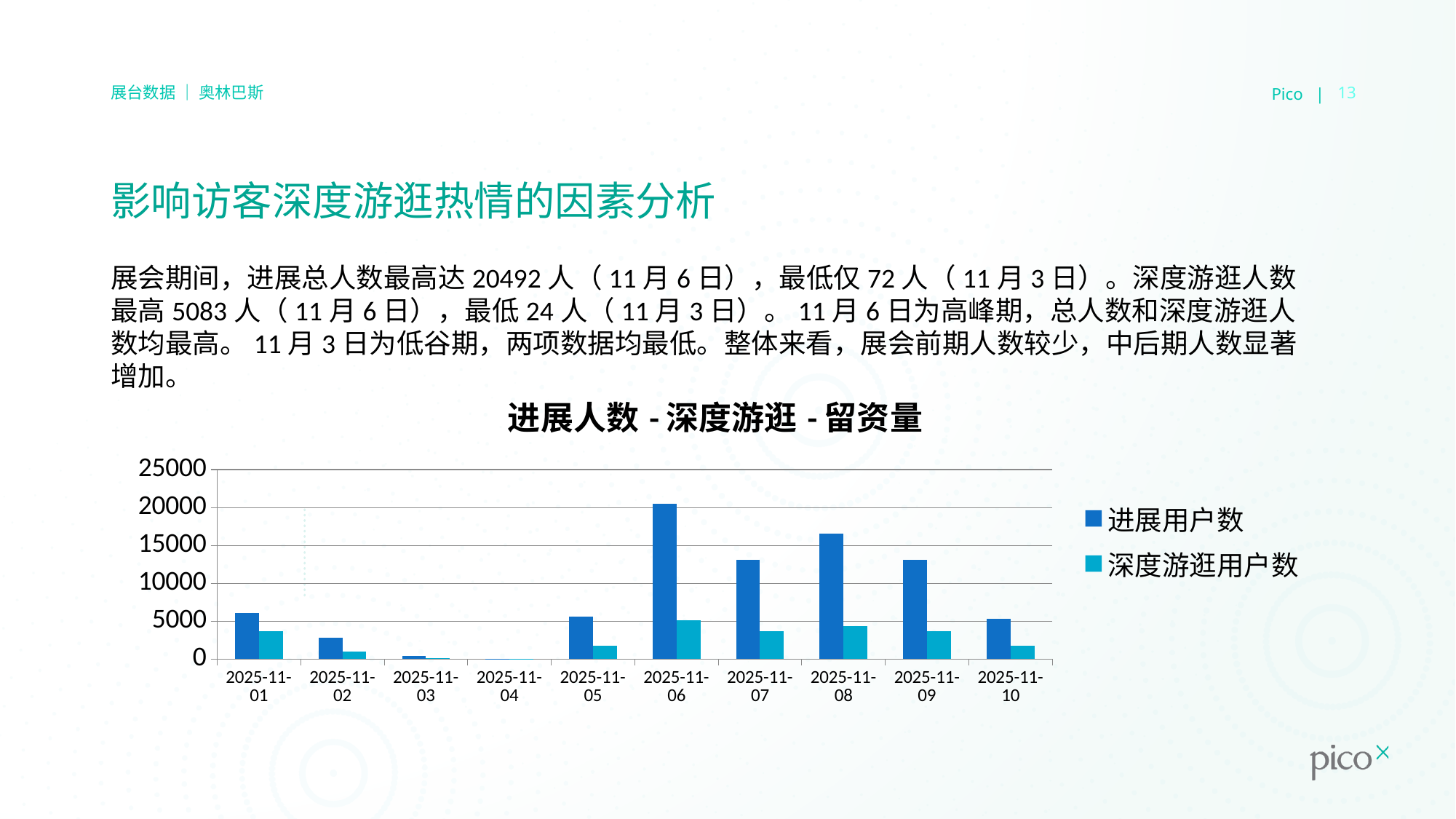
What kind of chart is shown on the slide? Bar chart Which date has the larger 进展用户数 value, 2025-11-07 or 2025-11-08? 2025-11-08 How many series does the chart legend list? 2 Is the 进展用户数 value for 2025-11-08 greater or less than 15000? greater Is the 进展用户数 value for 2025-11-07 greater or less than 15000? less On which date is the 深度游逛用户数 bar the highest? 2025-11-06 Which legend entry is shown in the lighter teal colour? 深度游逛用户数 On which date is the 进展用户数 bar the highest? 2025-11-06 Is the 深度游逛用户数 value for 2025-11-06 greater or less than 10000? less How many dates are shown on the x axis of the chart? 10 What is the title of the chart? 进展人数 - 深度游逛 - 留资量